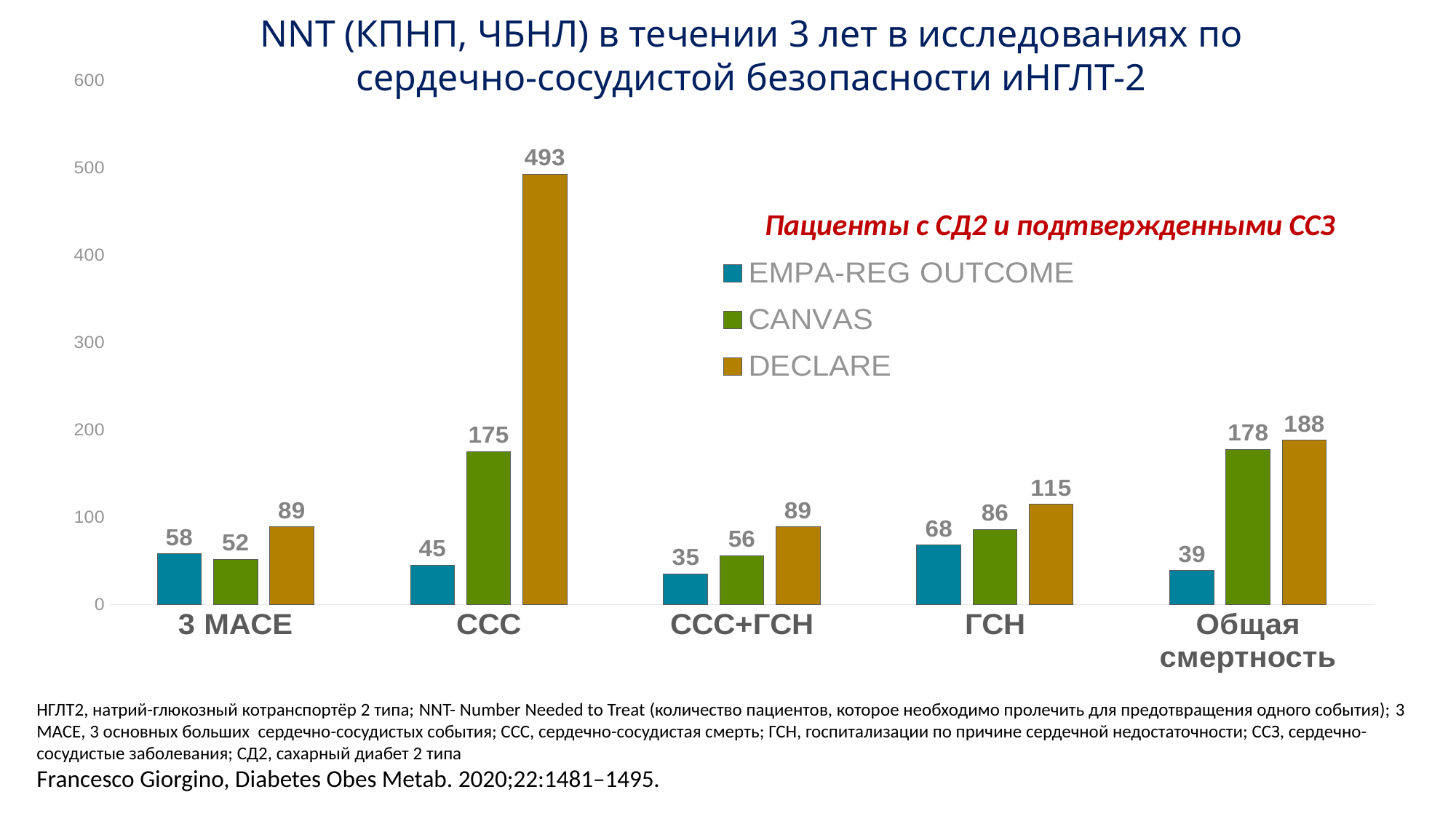
What kind of chart is shown on the slide? Bar chart Which category has the lowest EMPA-REG OUTCOME value? ССС+ГСН What is the difference between the DECLARE and CANVAS values in the ССС category? 318 Which series is shown in green in the legend? CANVAS In the ГСН category, which is larger: the EMPA-REG OUTCOME value or the DECLARE value? DECLARE What is the NNT value for CANVAS in the Общая смертность category? 178 Which category has the highest DECLARE value? ССС What is the NNT value for DECLARE in the ССС category? 493 How many categories are shown on the x axis? 5 What is the NNT value for CANVAS in the ГСН category? 86 What is the NNT value for EMPA-REG OUTCOME in the 3 MACE category? 58 How many series does the legend list? 3